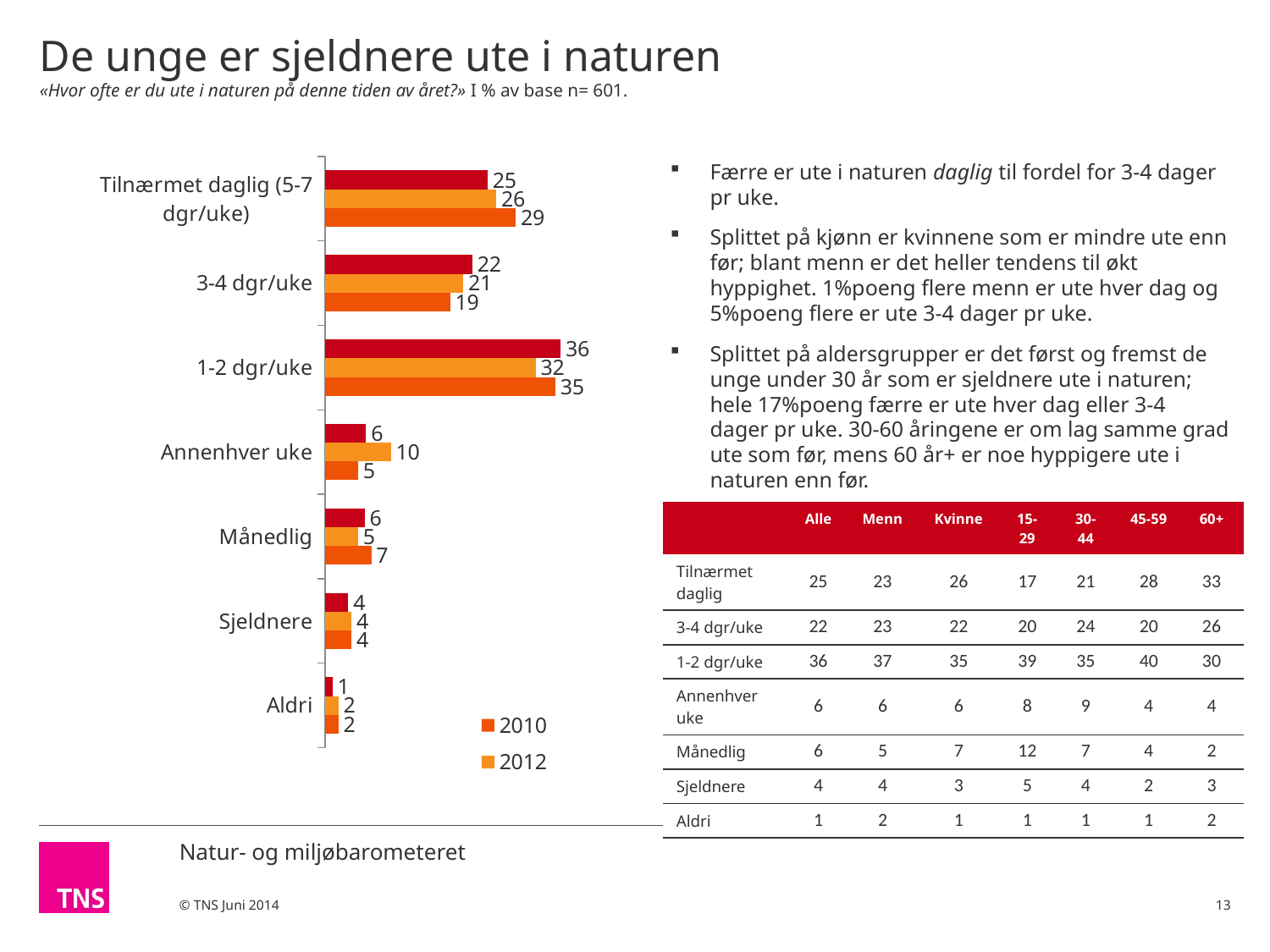
How many categories are shown on the chart's vertical axis? 7 How many series does the chart's legend list? 2 What is the value of the top (dark red) bar for '1-2 dgr/uke'? 36 What kind of chart is shown on the slide? bar chart For 'Annenhver uke', what is the difference between the middle bar and the bottom bar? 5 Which has the larger bottom-bar value: 'Tilnærmet daglig (5-7 dgr/uke)' or '3-4 dgr/uke'? Tilnærmet daglig (5-7 dgr/uke) Looking at the top (dark red) bars, which category has the lowest value? Aldri Which years are listed in the chart's legend? 2010 and 2012 What is the value of the bottom bar for 'Månedlig'? 7 What is the difference between the top bar for '1-2 dgr/uke' and the top bar for '3-4 dgr/uke'? 14 Looking at the top (dark red) bars, which category has the highest value? 1-2 dgr/uke What is the value of the middle (orange) bar for 'Annenhver uke'? 10